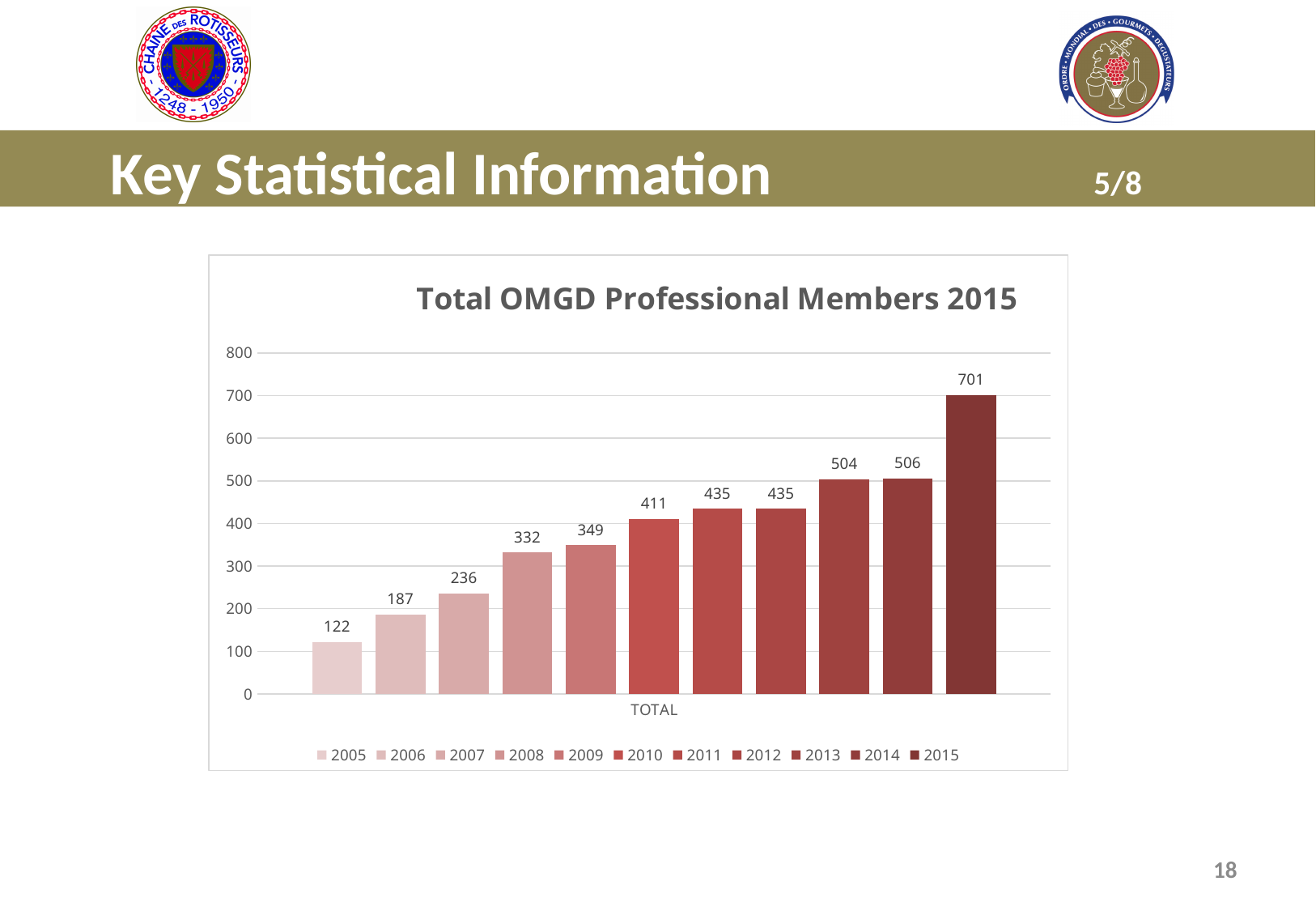
Which year has the highest value? 2015 Which is larger, the value for 2009 or the value for 2010? 2010 What is the difference between the values for 2015 and 2014? 195 Do the values generally rise or fall from 2005 to 2015? Rise How many series does the legend list? 11 Which year has the lowest value? 2005 What is the value for 2010? 411 What is the value for 2005? 122 What kind of chart is shown on the slide? Bar chart What is the title of the chart? Total OMGD Professional Members 2015 What is the value for 2015 in the Total OMGD Professional Members 2015 chart? 701 What is the difference between the values for 2008 and 2007? 96